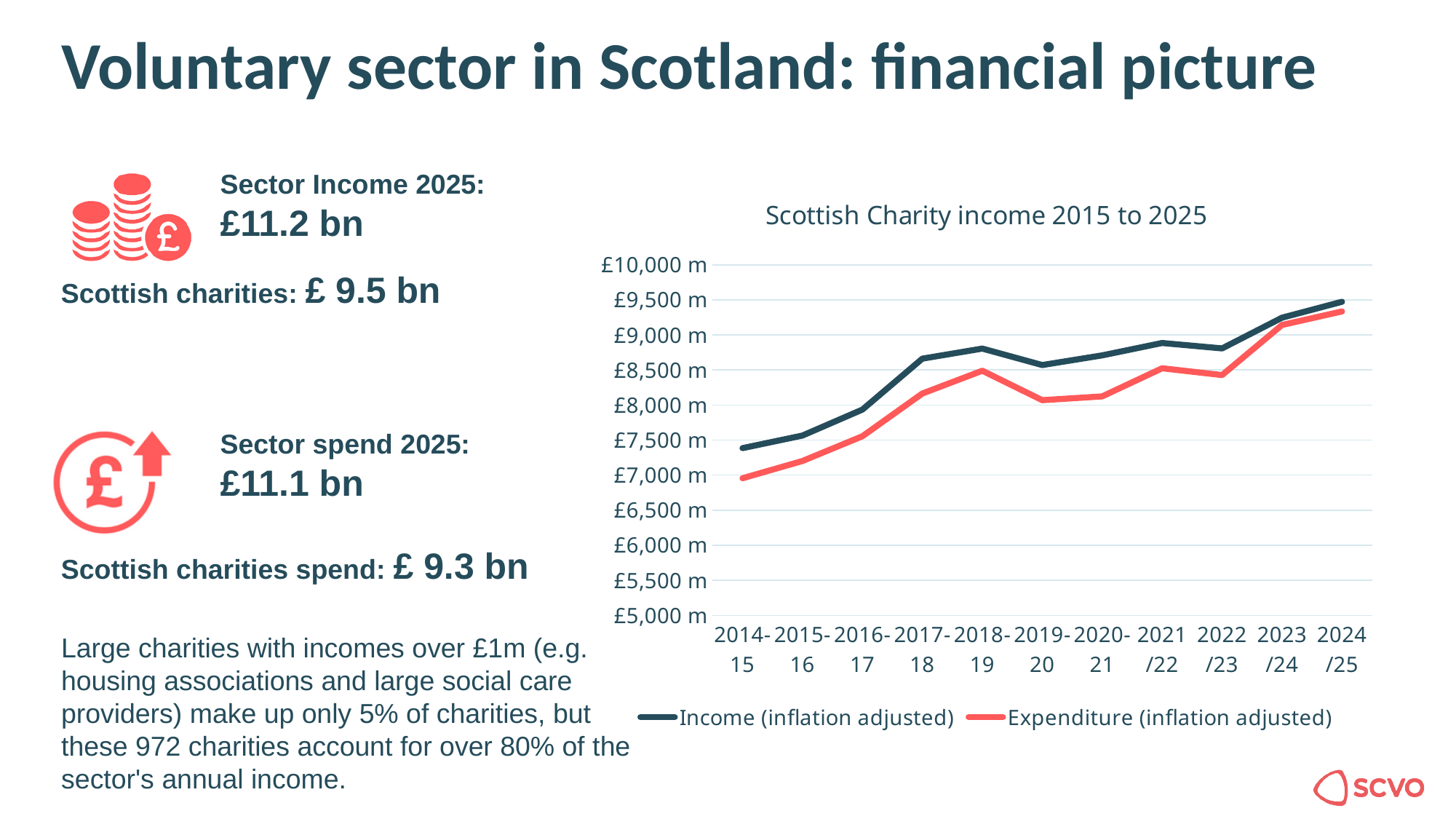
Is the value for Income (inflation adjusted) in 2024/25 greater or less than £9,000 m? greater How many years are plotted along the x axis of the chart? 11 In which year is Expenditure (inflation adjusted) lowest? 2014-15 How many series does the legend of the chart list? 2 In which year is Income (inflation adjusted) highest? 2024/25 What kind of chart is shown on the slide? Line chart Is the value for Expenditure (inflation adjusted) in 2019-20 greater or less than £8,500 m? less In 2019-20, which is larger: Income (inflation adjusted) or Expenditure (inflation adjusted)? Income (inflation adjusted) Overall, do the Income (inflation adjusted) values rise or fall from 2014-15 to 2024/25? Rise Which series in the chart is drawn in red? Expenditure (inflation adjusted) Is the value for Income (inflation adjusted) in 2014-15 greater or less than £7,500 m? less What is the title of the chart? Scottish Charity income 2015 to 2025